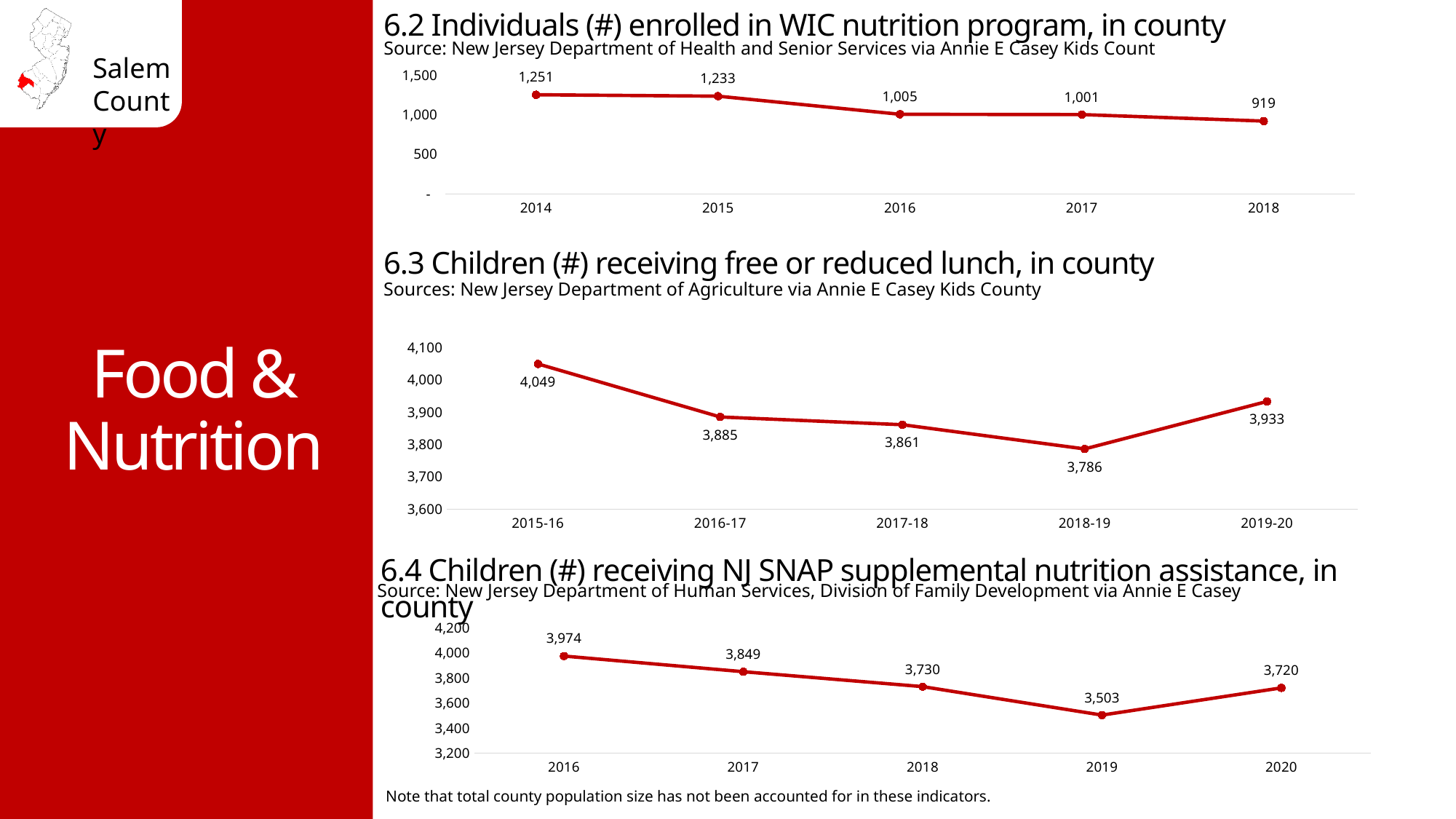
In the chart '6.4 Children (#) receiving NJ SNAP supplemental nutrition assistance, in county', what is the value for 2019? 3,503 In the chart '6.4 Children (#) receiving NJ SNAP supplemental nutrition assistance, in county', what is the difference between the 2016 and 2017 values? 125 In the chart '6.2 Individuals (#) enrolled in WIC nutrition program, in county', which year has the lowest value? 2018 In the chart '6.3 Children (#) receiving free or reduced lunch, in county', which school year has the highest value? 2015-16 In the chart '6.2 Individuals (#) enrolled in WIC nutrition program, in county', do the values generally rise or fall from 2014 to 2018? fall In the chart '6.3 Children (#) receiving free or reduced lunch, in county', how many data points are plotted? 5 In the chart '6.3 Children (#) receiving free or reduced lunch, in county', what is the value for 2018-19? 3,786 What type of chart is used for '6.4 Children (#) receiving NJ SNAP supplemental nutrition assistance, in county'? line chart How many charts are shown on the slide? 3 In the chart '6.2 Individuals (#) enrolled in WIC nutrition program, in county', what is the value for 2016? 1,005 In the chart '6.2 Individuals (#) enrolled in WIC nutrition program, in county', what is the difference between the 2014 and 2018 values? 332 In the chart '6.3 Children (#) receiving free or reduced lunch, in county', which is larger, the value for 2016-17 or the value for 2019-20? 2019-20